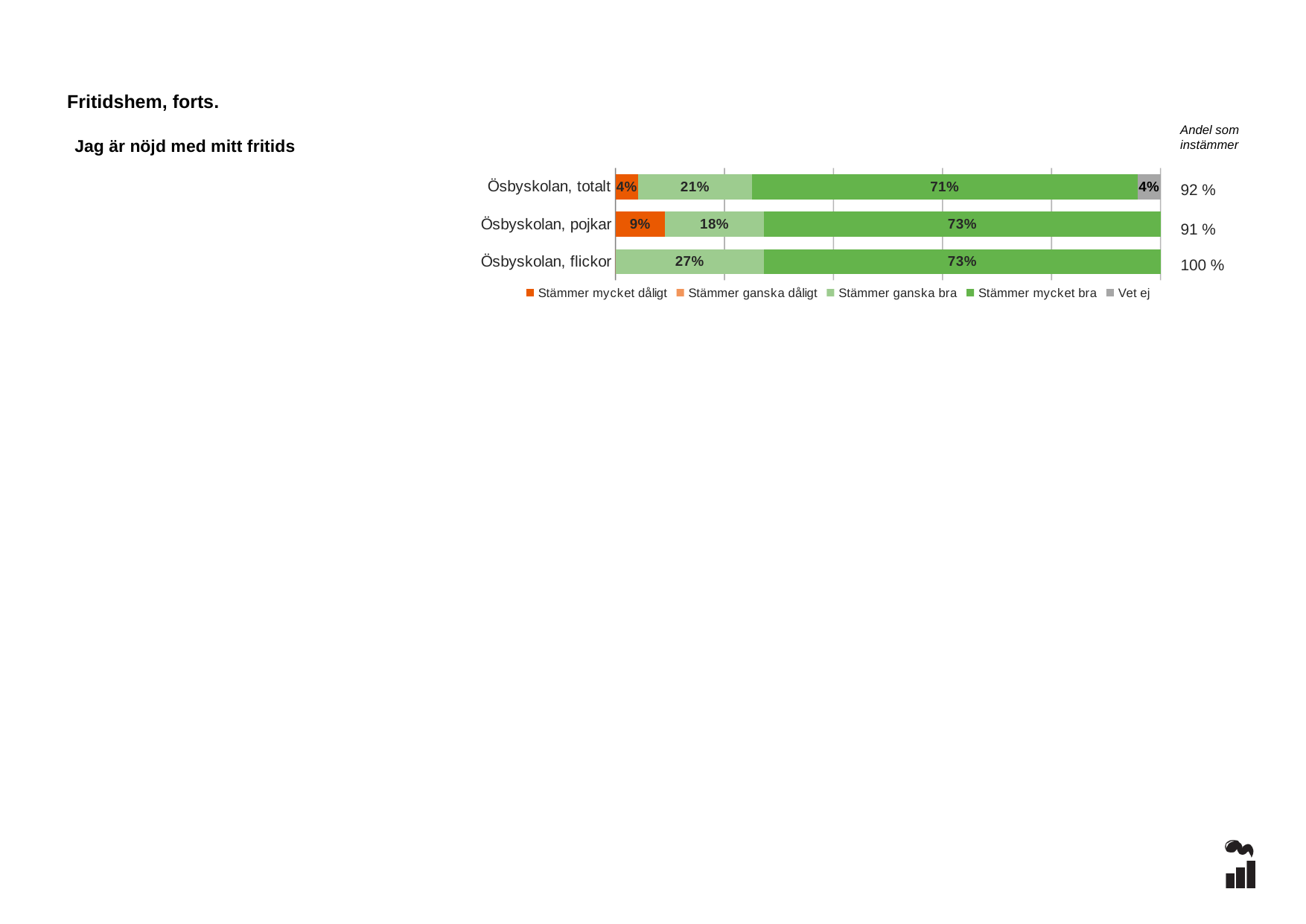
What percentage of Ösbyskolan, totalt answered 'Stämmer mycket bra'? 71% What is the 'Andel som instämmer' value shown for Ösbyskolan, flickor? 100 % Which category has the highest 'Stämmer ganska bra' share? Ösbyskolan, flickor What kind of chart is shown? Stacked bar chart What percentage of Ösbyskolan, pojkar answered 'Stämmer mycket dåligt'? 9% What percentage of Ösbyskolan, flickor answered 'Stämmer ganska bra'? 27% What is the difference between the 'Stämmer ganska bra' shares for Ösbyskolan, flickor and Ösbyskolan, pojkar? 9 percentage points How many series does the legend list? 5 How many categories are shown on the chart? 3 What percentage of Ösbyskolan, totalt answered 'Vet ej'? 4% Which is larger: the 'Stämmer mycket dåligt' share for Ösbyskolan, pojkar or for Ösbyskolan, totalt? Ösbyskolan, pojkar Which category has the lowest 'Stämmer mycket bra' share? Ösbyskolan, totalt